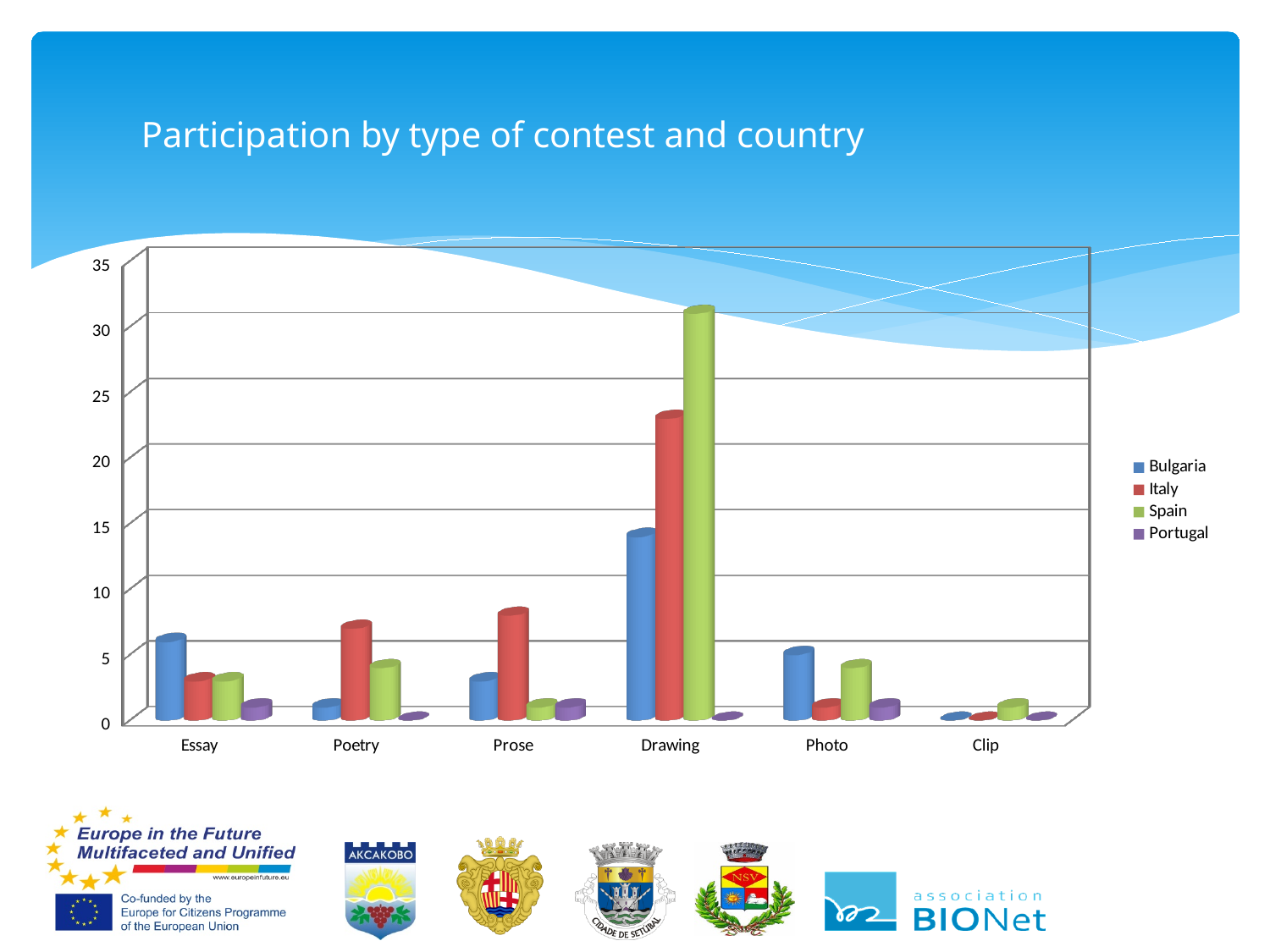
How many contest types are shown on the x axis? 6 Which country has the highest participation in Essay? Bulgaria Is Italy's value for Drawing greater or less than 20? greater For which contest type is Spain's participation highest? Drawing Is Spain's value for Drawing greater or less than 25? greater Which country has the highest participation in Poetry? Italy Which is larger in Drawing, Italy or Bulgaria? Italy Which is larger in Photo, Bulgaria or Italy? Bulgaria How many countries does the legend list? 4 What is the title of the chart? Participation by type of contest and country What type of chart is shown on the slide? Bar chart